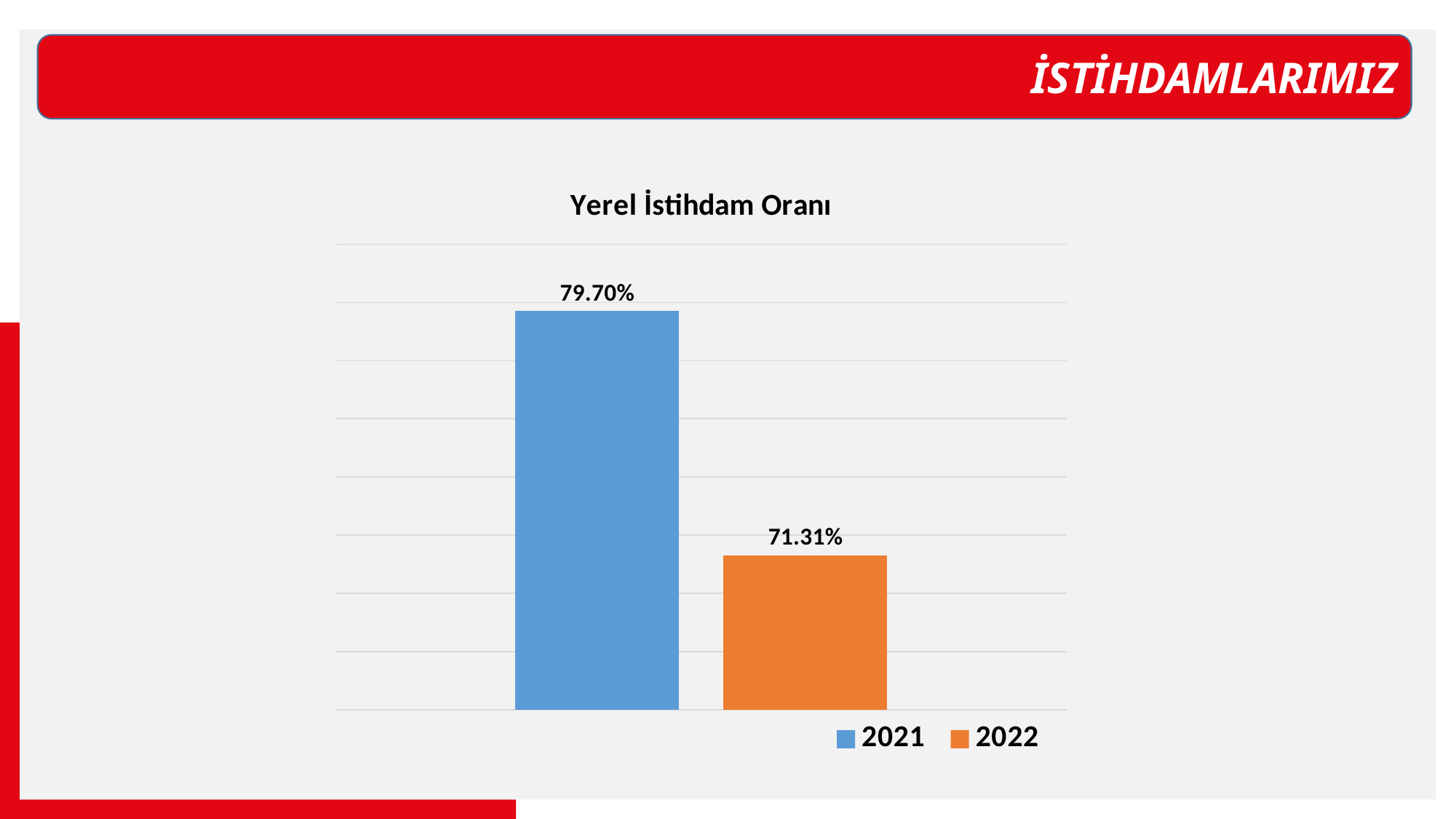
Which year has the higher value in the Yerel İstihdam Oranı chart? 2021 Do the values rise or fall from 2021 to 2022 in the Yerel İstihdam Oranı chart? fall What is the difference between the 2021 and 2022 values in the Yerel İstihdam Oranı chart? 8.39% Which year has the lower value in the Yerel İstihdam Oranı chart? 2022 What kind of chart is shown on the slide? bar chart What is the value for 2021 in the Yerel İstihdam Oranı chart? 79.70% Is the value for 2021 larger or smaller than the value for 2022? larger What is the value for 2022 in the Yerel İstihdam Oranı chart? 71.31% What colour is the bar for 2022 in the Yerel İstihdam Oranı chart? orange What is the title of the chart on the slide? Yerel İstihdam Oranı How many series does the legend list in the Yerel İstihdam Oranı chart? 2 How many bars are plotted in the Yerel İstihdam Oranı chart? 2